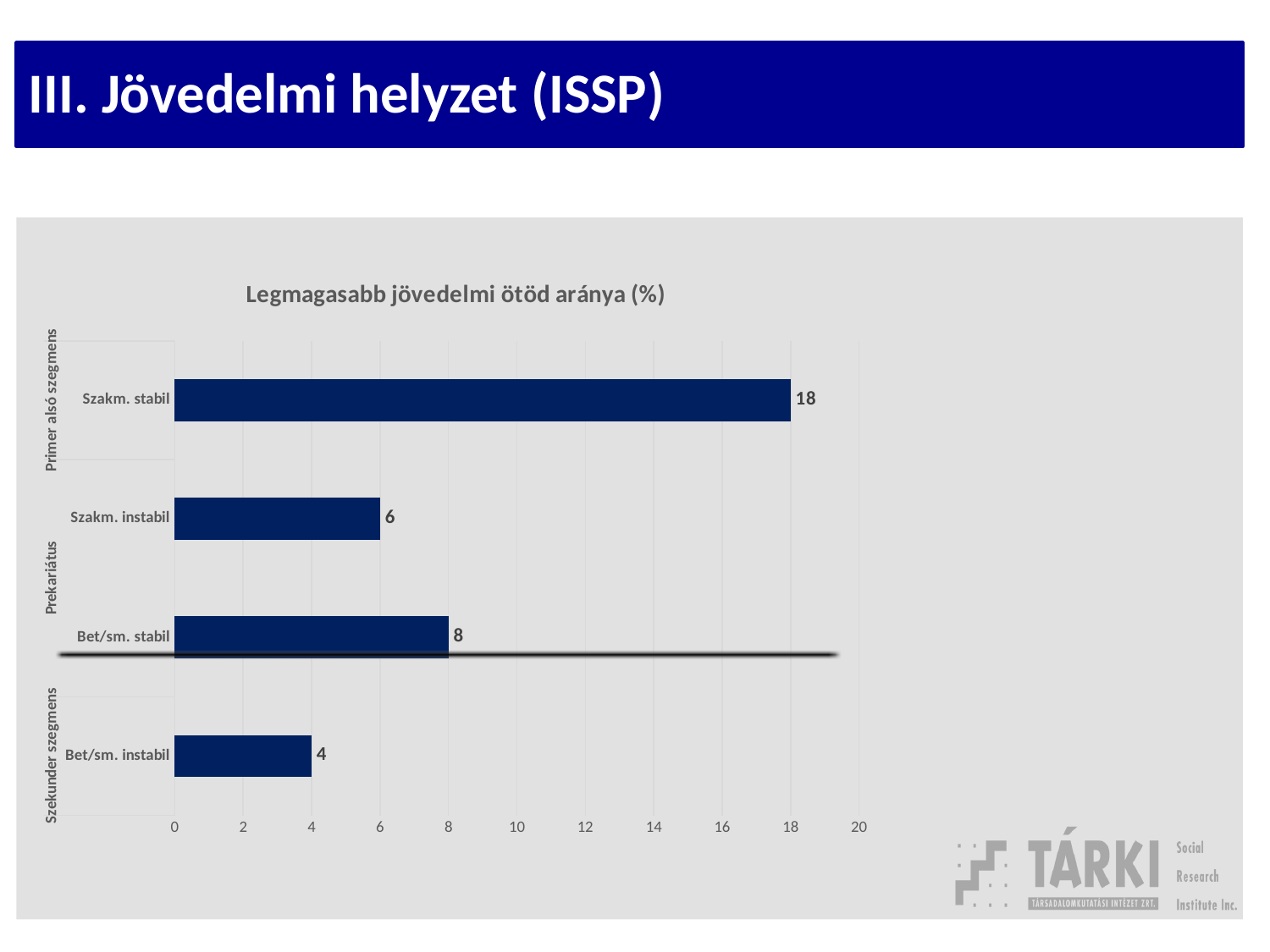
What is the value for Szakm. stabil? 18 What is the difference between the values for Szakm. stabil and Bet/sm. stabil? 10 How many categories are shown in the chart? 4 What is the value for Szakm. instabil? 6 Which category has the highest value? Szakm. stabil What kind of chart is shown on the slide? bar chart What is the title of the chart? Legmagasabb jövedelmi ötöd aránya (%) What is the difference between the values for Szakm. instabil and Bet/sm. instabil? 2 Which category has the lowest value? Bet/sm. instabil What is the value for Bet/sm. instabil? 4 What is the maximum value shown on the x axis? 20 Which is larger, the value for Bet/sm. stabil or Szakm. instabil? Bet/sm. stabil